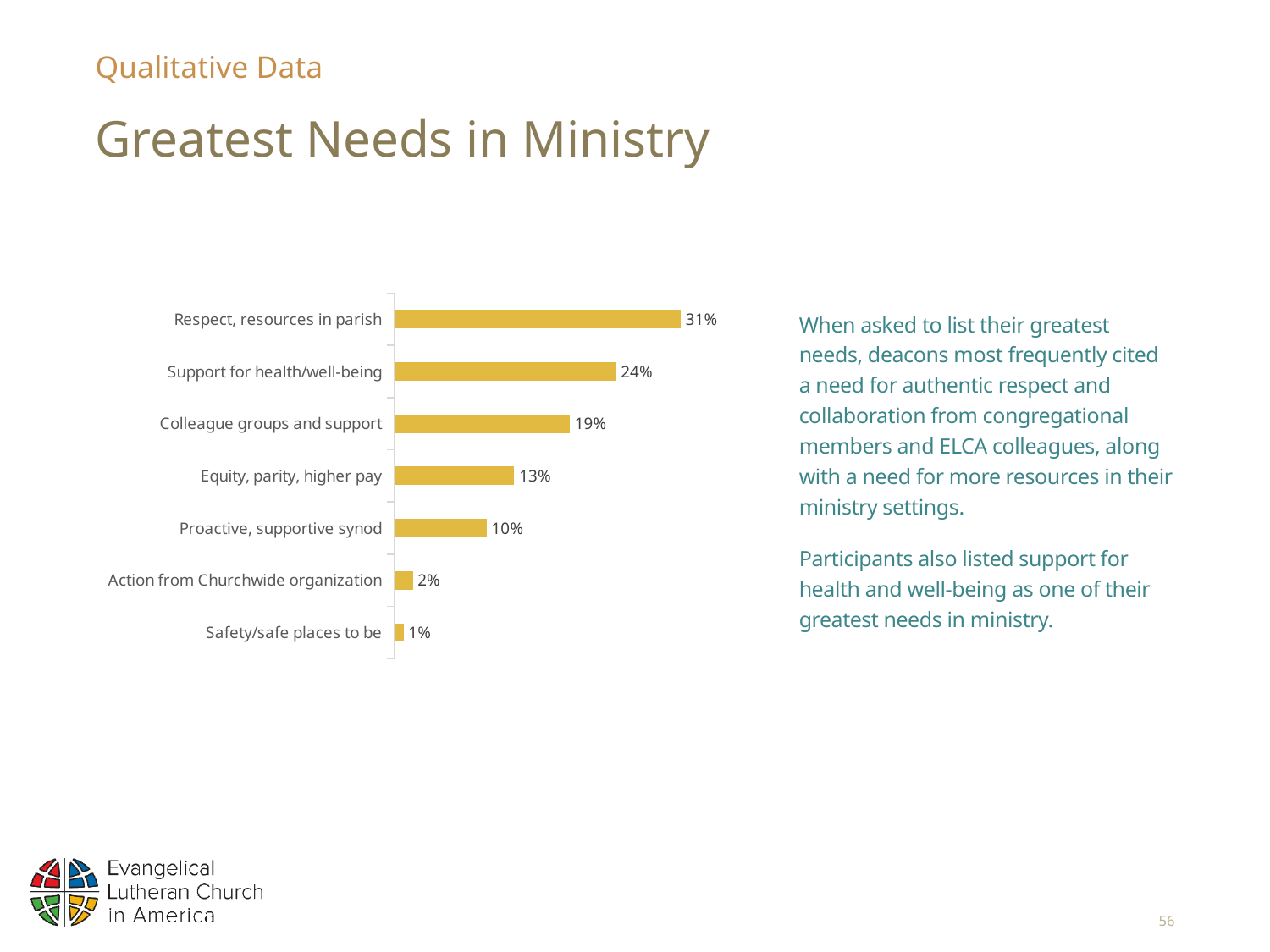
What is the value for "Action from Churchwide organization"? 2% What kind of chart is shown on the slide? Bar chart Which is larger: "Colleague groups and support" or "Equity, parity, higher pay"? Colleague groups and support How many categories are shown in the chart? 7 Which category has the highest value? Respect, resources in parish What is the value for "Support for health/well-being"? 24% Which category has the lowest value? Safety/safe places to be What percentage is shown for "Proactive, supportive synod"? 10% What is the difference between "Colleague groups and support" and "Equity, parity, higher pay"? 6% What percentage is shown for "Respect, resources in parish"? 31% What colour are the bars in the chart? Gold/yellow What is the difference between "Respect, resources in parish" and "Support for health/well-being"? 7%